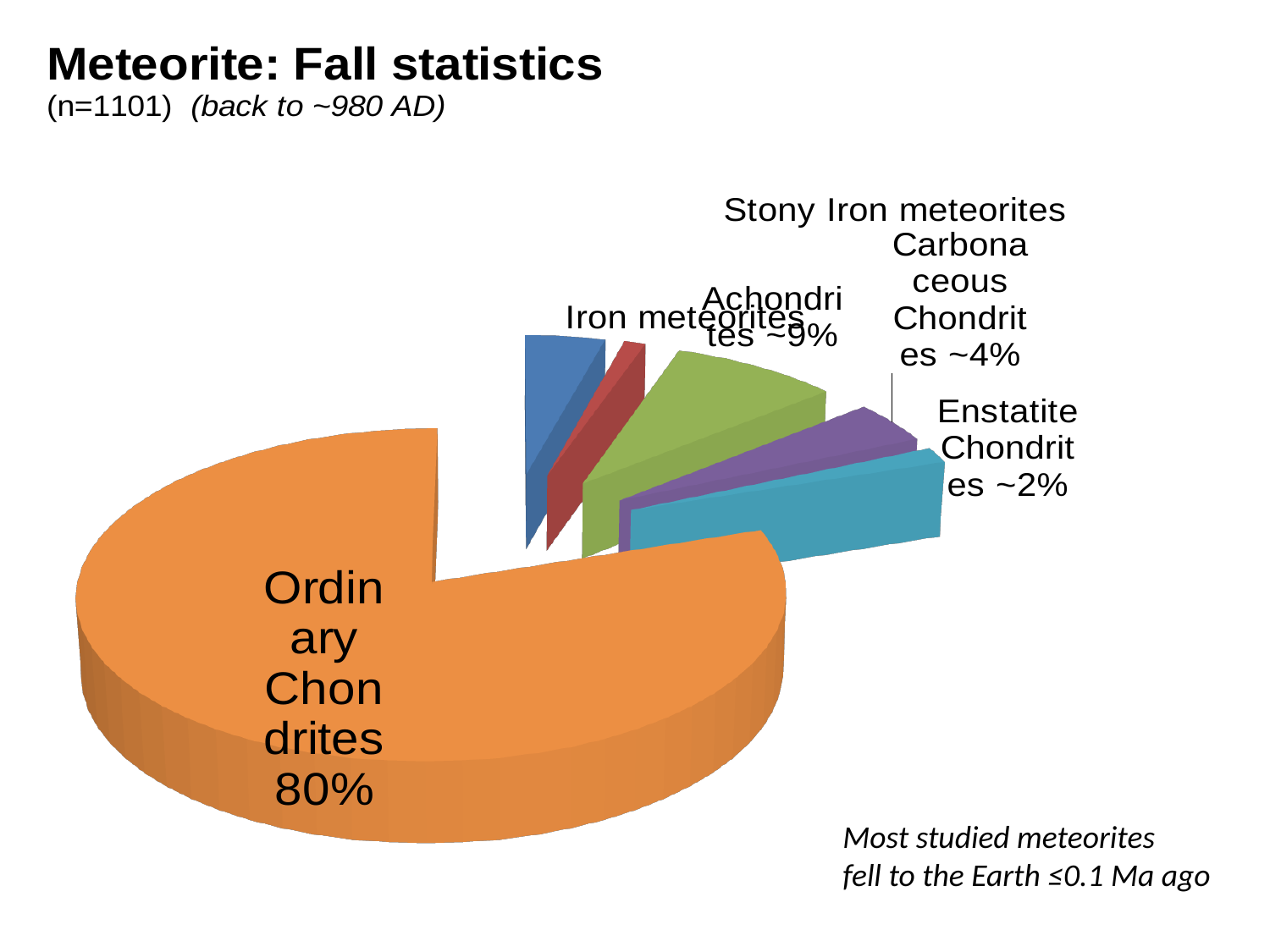
What share of the pie do Ordinary Chondrites make up? 80% What value is shown for Enstatite Chondrites? ~2% Which is larger, the slice for Ordinary Chondrites or the slice for Iron meteorites? Ordinary Chondrites What value is shown for Carbonaceous Chondrites? ~4% What value is shown for Achondrites? ~9% What kind of chart is shown on the slide? pie chart Which is larger, the slice for Achondrites or the slice for Carbonaceous Chondrites? Achondrites Which category has the largest slice of the pie? Ordinary Chondrites What is the title of the slide containing the chart? Meteorite: Fall statistics What colour is the Ordinary Chondrites slice? orange What percentage of meteorite falls are Ordinary Chondrites? 80% How many slices does the pie chart have? 6